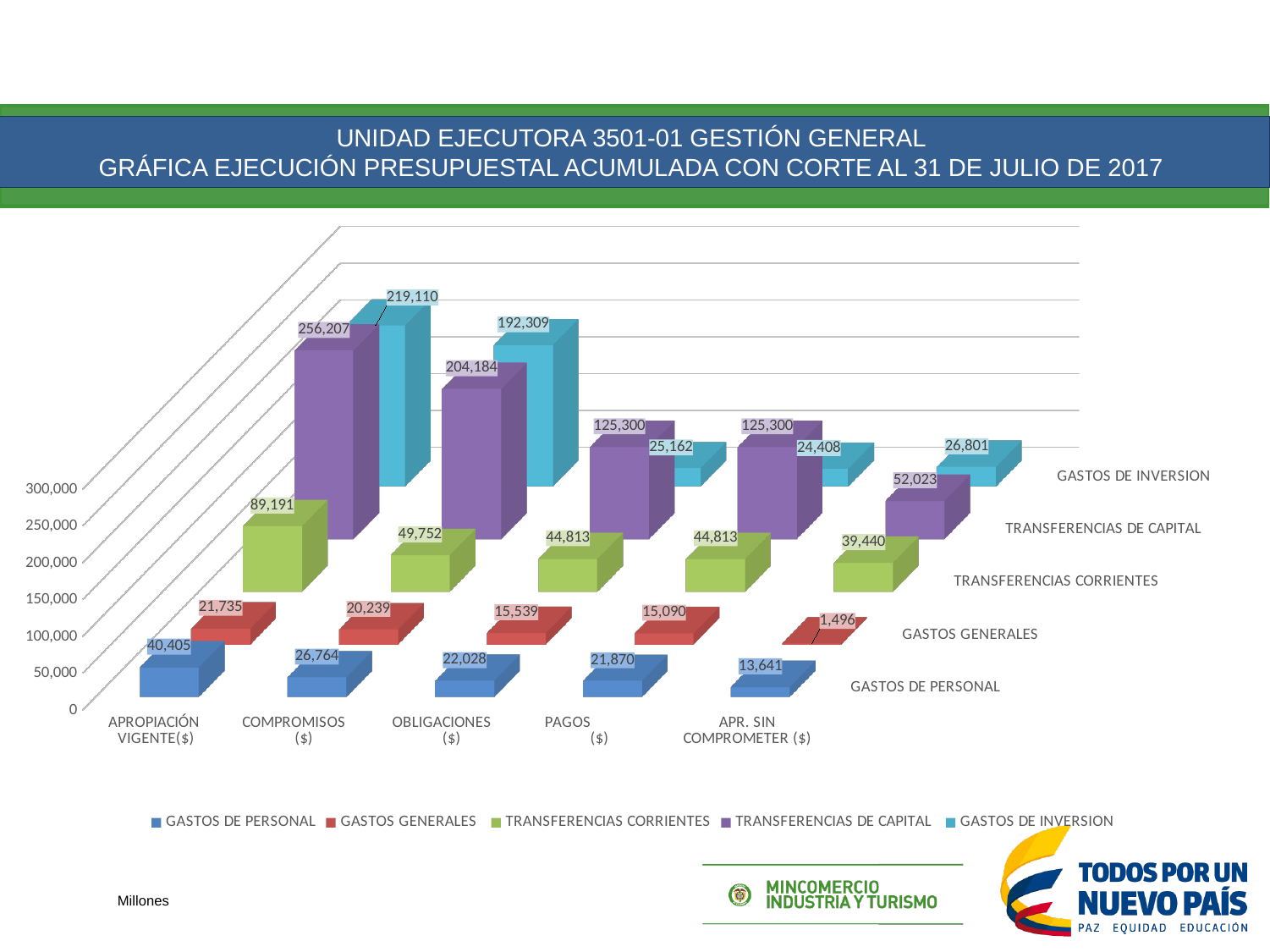
How many categories are shown on the x axis? 5 Which is larger for PAGOS ($): TRANSFERENCIAS CORRIENTES or GASTOS DE INVERSION? TRANSFERENCIAS CORRIENTES Do the GASTOS DE PERSONAL values rise or fall from APROPIACIÓN VIGENTE($) to APR. SIN COMPROMETER ($)? Fall What kind of chart is shown on the slide? Bar chart What is the value of GASTOS DE PERSONAL for APROPIACIÓN VIGENTE($)? 40,405 What is the value of GASTOS DE INVERSION for OBLIGACIONES ($)? 25,162 What is the difference between the TRANSFERENCIAS DE CAPITAL values for APROPIACIÓN VIGENTE($) and COMPROMISOS ($)? 52,023 Which category has the highest value for TRANSFERENCIAS CORRIENTES? APROPIACIÓN VIGENTE($) How many series does the legend list? 5 What is the value of GASTOS GENERALES for APR. SIN COMPROMETER ($)? 1,496 What is the value of TRANSFERENCIAS DE CAPITAL for COMPROMISOS ($)? 204,184 Which category has the lowest value for GASTOS DE PERSONAL? APR. SIN COMPROMETER ($)